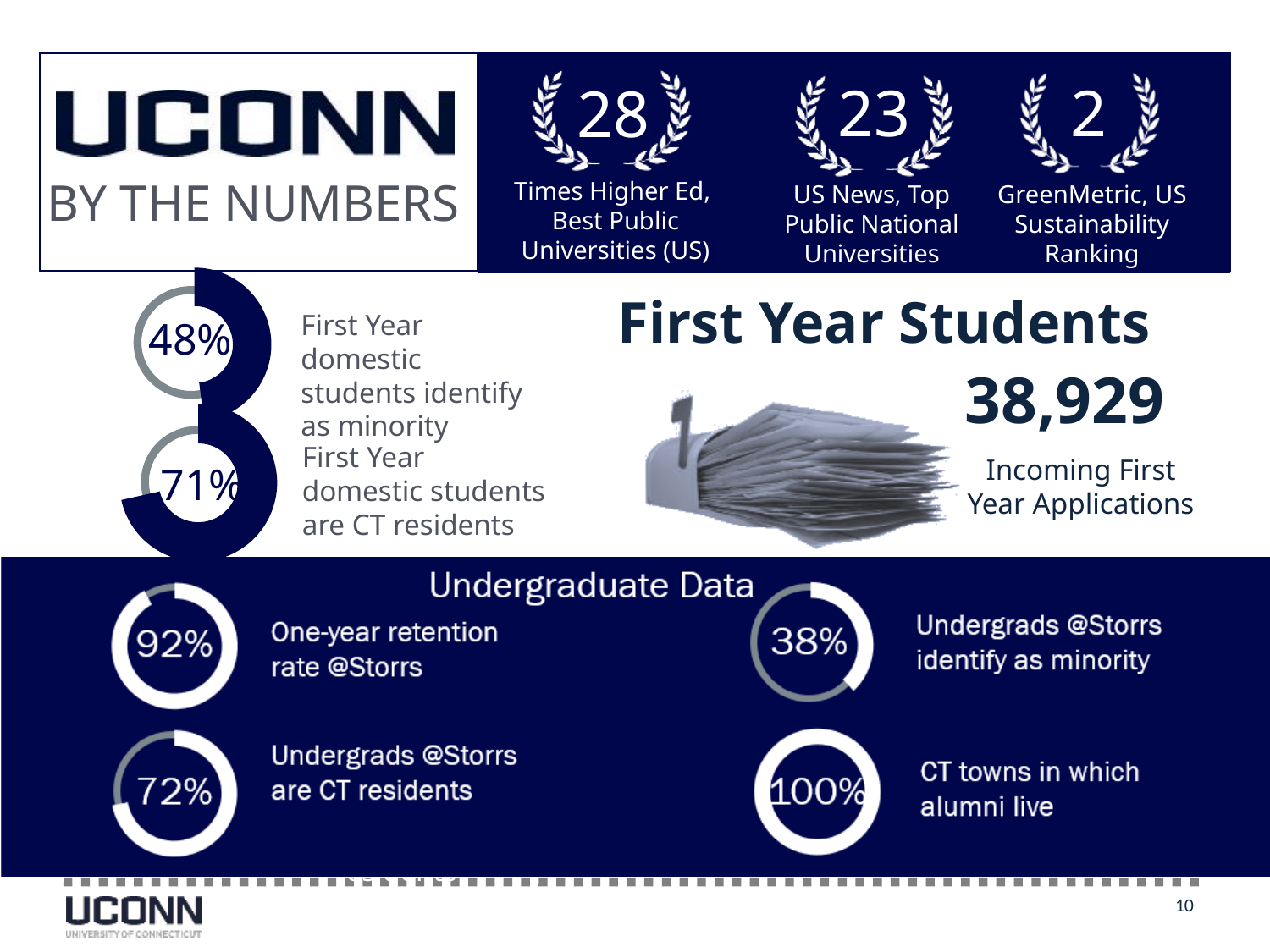
In the Undergraduate Data section, what percentage of Undergrads @Storrs identify as minority? 38% In the Undergraduate Data section, what is the one-year retention rate @Storrs shown in the donut chart? 92% What percentage of First Year domestic students identify as minority, according to the donut chart in the middle-left section? 48% Among the four donut charts in the Undergraduate Data section, which metric has the highest value? CT towns in which alumni live (100%) In the Undergraduate Data section, what percentage of Undergrads @Storrs are CT residents? 72% What is the difference between the share of First Year domestic students who are CT residents (71%) and the share of Undergrads @Storrs who are CT residents (72%)? 1 percentage point In the Undergraduate Data section, what percentage of CT towns have alumni living in them? 100% What percentage of First Year domestic students are CT residents, according to the donut chart in the middle-left section? 71% What kind of chart is used to show the 92% one-year retention rate @Storrs? Donut chart Among the four donut charts in the Undergraduate Data section, which metric has the lowest value? Undergrads @Storrs identify as minority (38%) How many donut charts are shown in the Undergraduate Data section of the slide? 4 Which is larger: the share of First Year domestic students who identify as minority (48%) or the share of Undergrads @Storrs who identify as minority (38%)? First Year domestic students (48%)